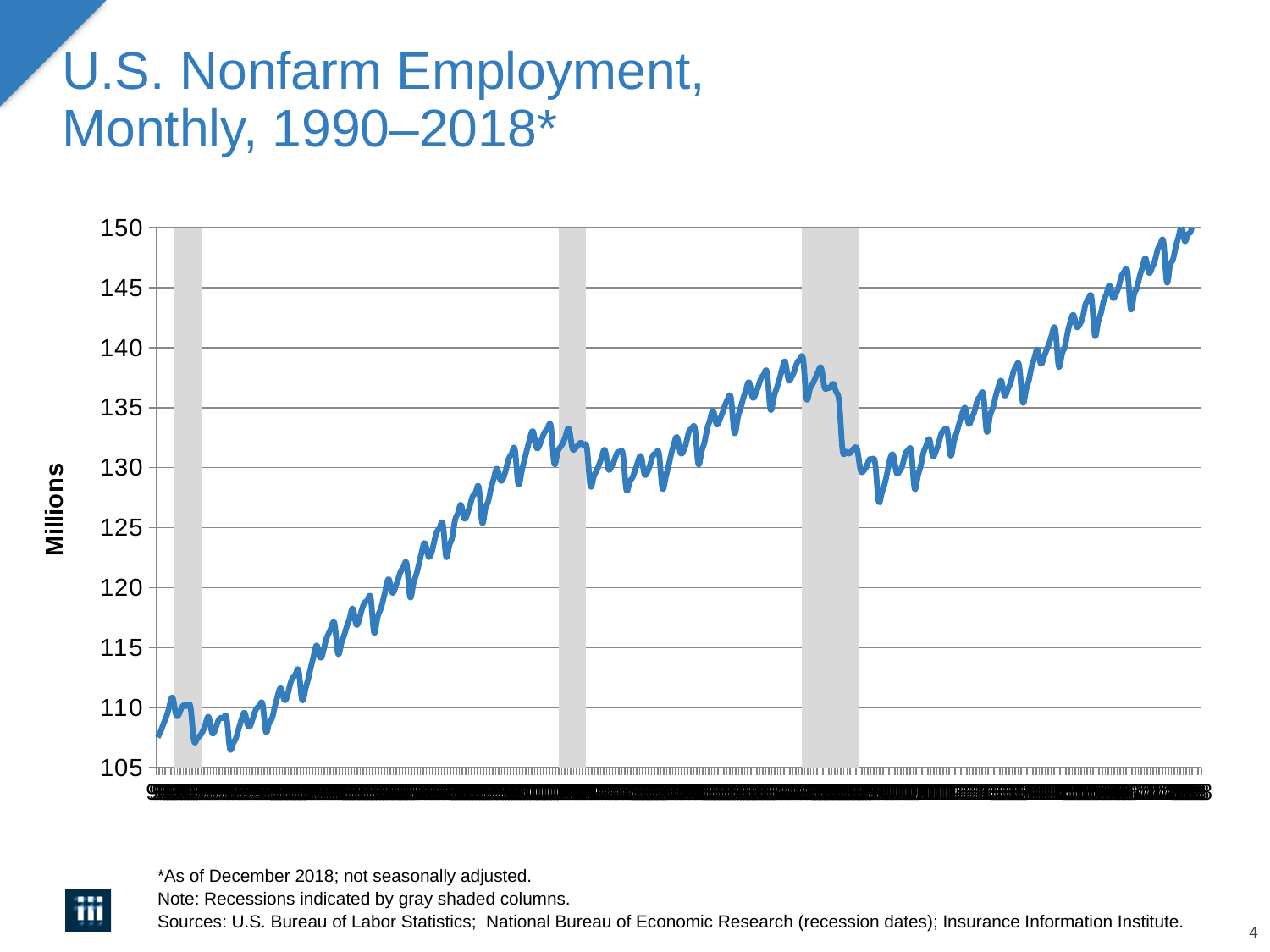
Is the peak reached just before the third gray shaded column greater or less than 135? greater Which is larger: the value at the right end of the line or the value at the left end of the line? the right end Is the low point reached after the third gray shaded column greater or less than 130? less What is the label on the vertical axis of the chart? Millions Is the value at the left end of the line (the earliest point) greater or less than 110? less Overall, do the values rise or fall from the left to the right of the chart? rise What kind of chart is shown on the slide? line chart What is the highest value shown on the vertical axis? 150 What is the title of the chart? U.S. Nonfarm Employment, Monthly, 1990–2018* How many gray shaded recession columns are shown on the chart? 3